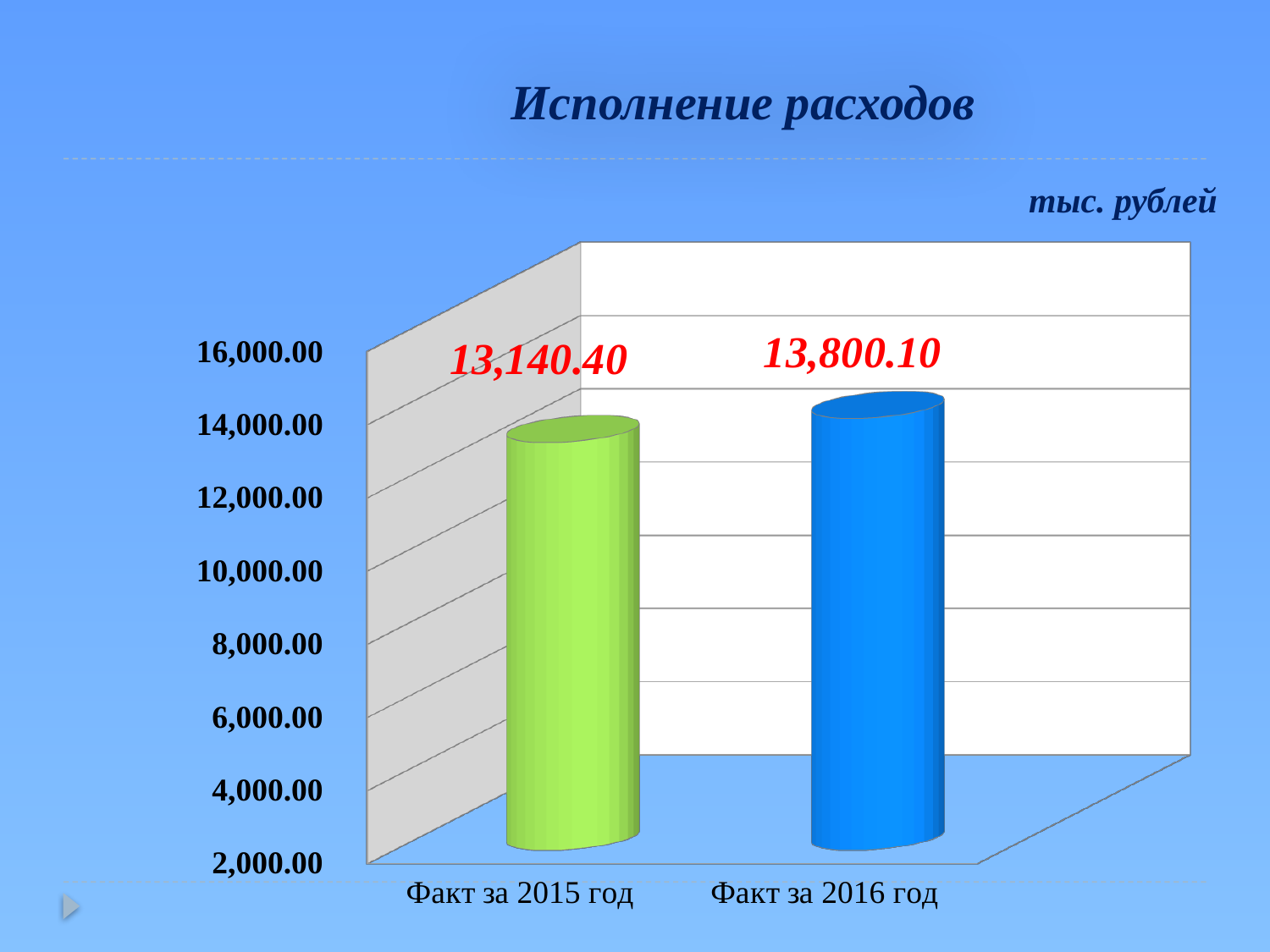
What is the title of the chart? Исполнение расходов Which is larger, the value for Факт за 2015 год or the value for Факт за 2016 год? Факт за 2016 год What kind of chart is shown on the slide? bar chart What is the difference between the values for Факт за 2016 год and Факт за 2015 год? 659.70 What is the value for Факт за 2016 год? 13,800.10 Do the values rise or fall from Факт за 2015 год to Факт за 2016 год? rise Is the value for Факт за 2016 год greater or less than 12,000.00? greater Which category has the lowest value? Факт за 2015 год What is the value for Факт за 2015 год? 13,140.40 How many categories are shown on the chart? 2 Which category has the highest value? Факт за 2016 год Is the value for Факт за 2015 год greater or less than 14,000.00? less